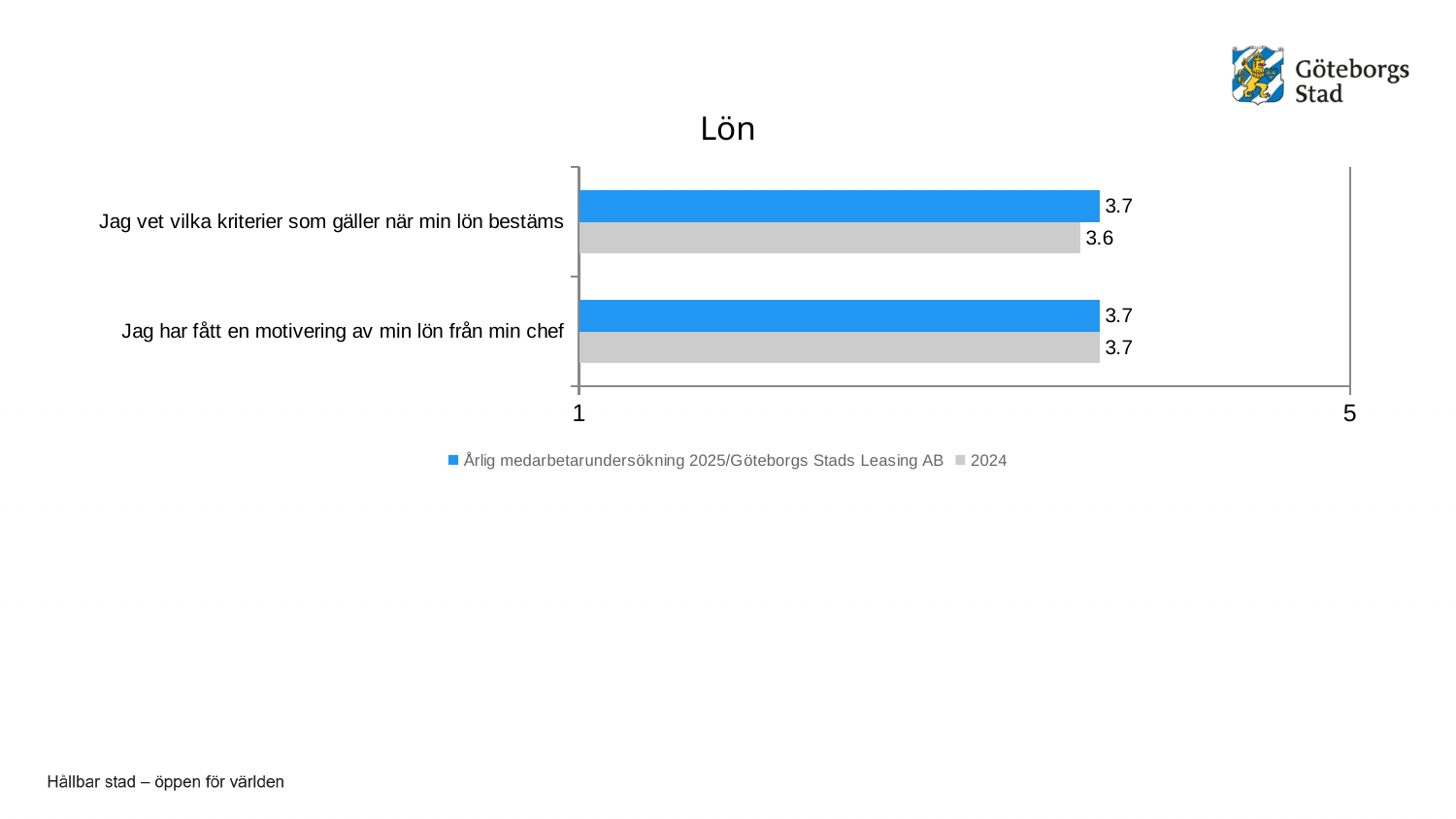
What kind of chart is shown on the slide? bar chart What is the difference between the 2025 and 2024 values for "Jag vet vilka kriterier som gäller när min lön bestäms"? 0.1 How many categories are shown on the chart? 2 What is the value for "Jag vet vilka kriterier som gäller när min lön bestäms" in the 2024 series? 3.6 What is the value for "Jag vet vilka kriterier som gäller när min lön bestäms" in the series "Årlig medarbetarundersökning 2025/Göteborgs Stads Leasing AB"? 3.7 What is the maximum value shown on the x axis? 5 How many series does the legend list? 2 What is the value for "Jag har fått en motivering av min lön från min chef" in the series "Årlig medarbetarundersökning 2025/Göteborgs Stads Leasing AB"? 3.7 What is the value for "Jag har fått en motivering av min lön från min chef" in the 2024 series? 3.7 What is the title of the chart? Lön Which series has the lower value for "Jag vet vilka kriterier som gäller när min lön bestäms"? 2024 Which colour represents the 2024 series? grey